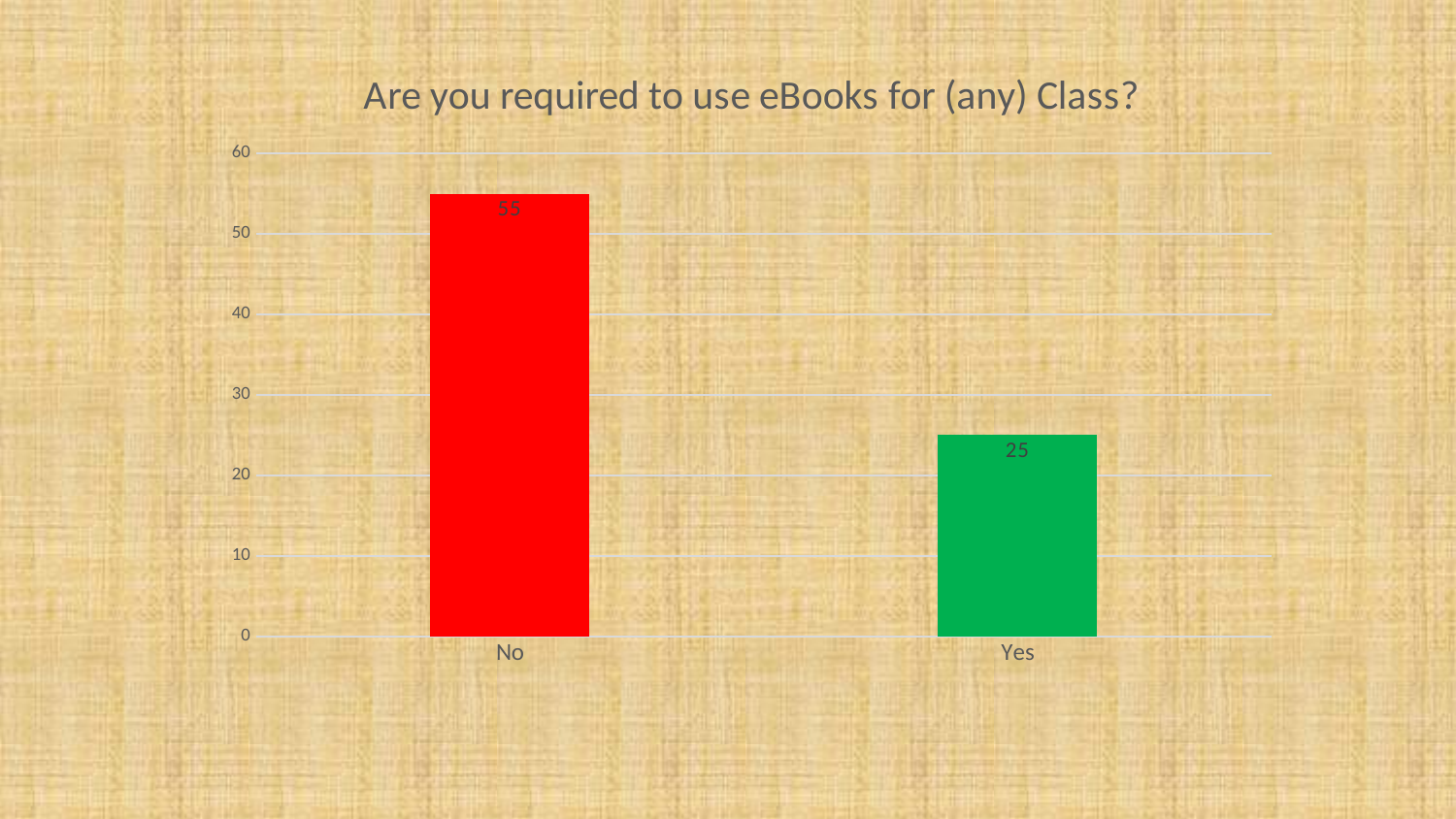
What kind of chart is shown on the slide? bar chart How many categories are shown on the x axis? 2 What is the difference between the values for "No" and "Yes"? 30 Which category has the lowest value? Yes Which category has the highest value? No Is the value for "No" greater or less than 50? greater What is the value for "No"? 55 What colour is the bar for "Yes"? green What is the title of the chart? Are you required to use eBooks for (any) Class? Which is larger, the value for "No" or the value for "Yes"? No What is the value for "Yes"? 25 Is the value for "Yes" greater or less than 30? less